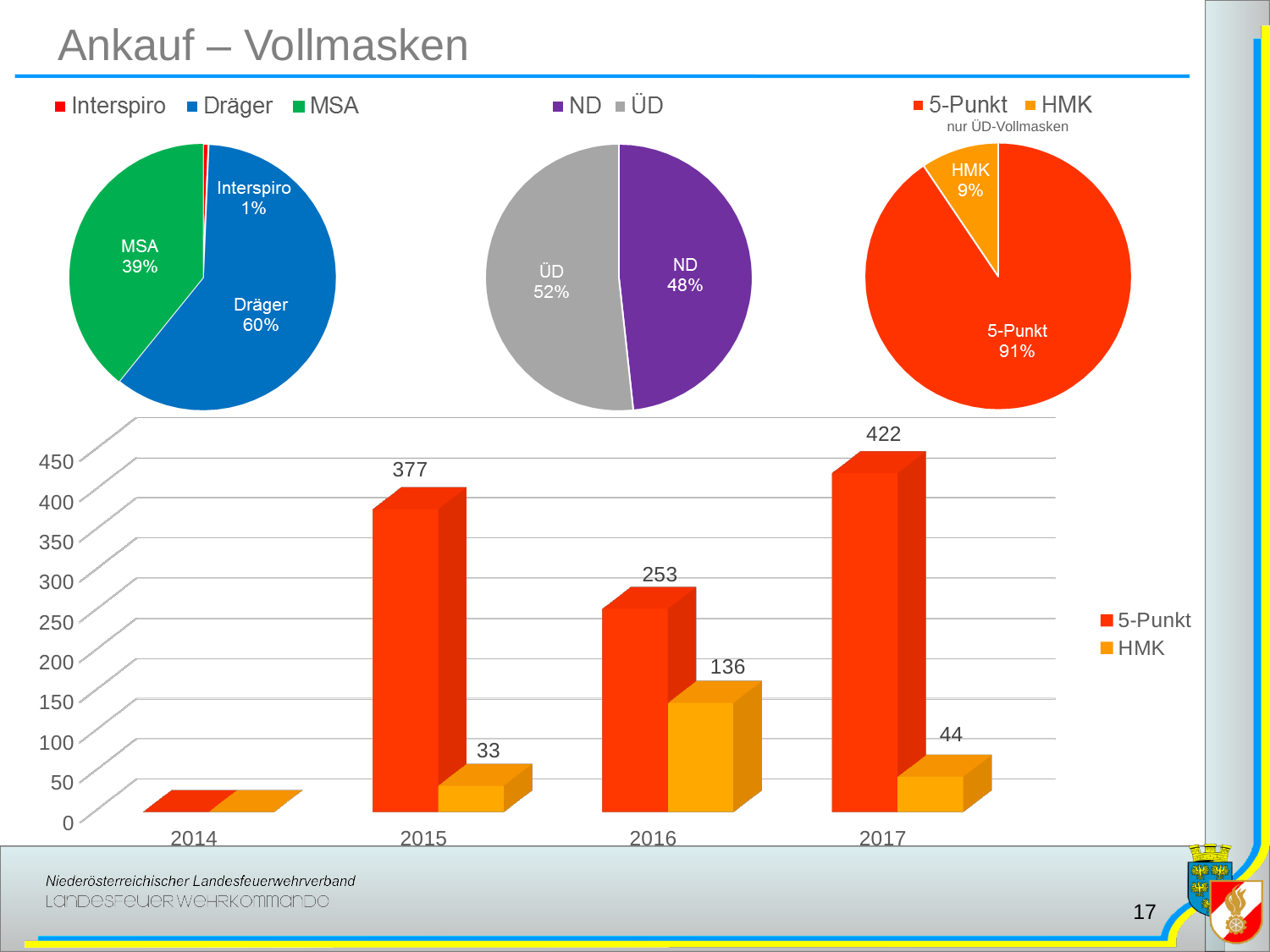
In the top-left pie chart, what share does Dräger have? 60% In the bottom bar chart, how many years are shown on the x axis? 4 In the bottom bar chart, what is the 5-Punkt value for 2015? 377 What kind of chart is the bottom chart on the slide? Bar chart In the bottom bar chart, how many series does the legend list? 2 In the bottom bar chart, which year has the highest 5-Punkt value? 2017 In the bottom bar chart, what is the difference between the 5-Punkt and HMK values in 2017? 378 In the bottom bar chart, what is the HMK value for 2016? 136 In the top-middle pie chart, what share does ÜD have? 52% In the top-left pie chart, which brand has the smallest slice? Interspiro In the top-middle pie chart, which is larger, ND or ÜD? ÜD In the top-right pie chart, what share does HMK have? 9%